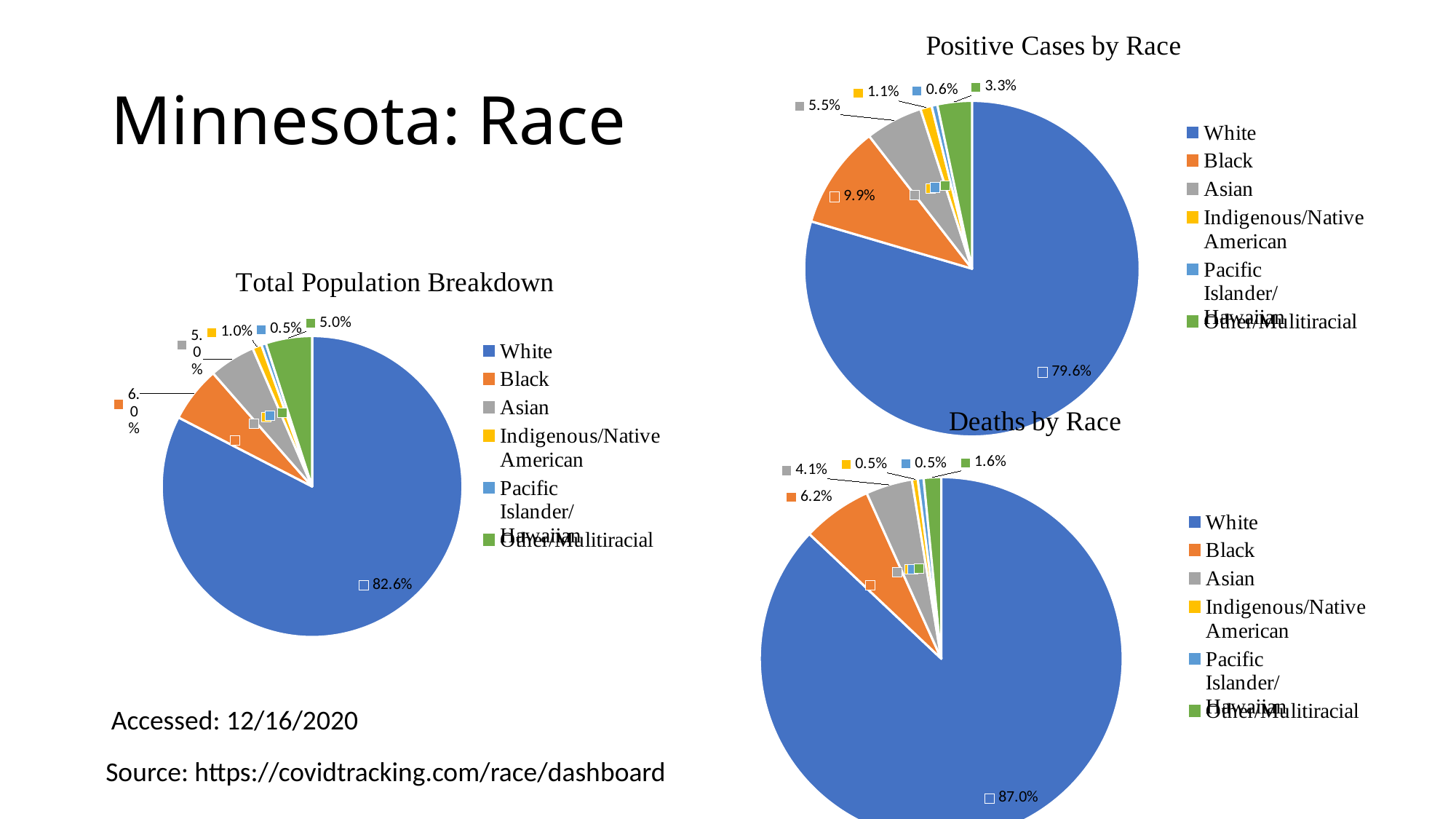
In the Positive Cases by Race chart, what percentage is shown for White? 79.6% Which is larger: the Black share in the Positive Cases by Race chart or the Black share in the Deaths by Race chart? Positive Cases by Race In the Deaths by Race chart, what is the difference between the White share and the Black share? 80.8% In the Total Population Breakdown chart, what percentage is shown for White? 82.6% In the Positive Cases by Race chart, which race has the largest share? White In the Positive Cases by Race chart, what percentage is shown for Asian? 5.5% How many slices does the Deaths by Race pie chart have? 6 In the Deaths by Race chart, what percentage is shown for Other/Multiracial? 1.6% How many charts are shown on the slide? 3 In the Deaths by Race chart, what percentage is shown for Black? 6.2% What type of chart is the Total Population Breakdown chart? Pie chart In the Positive Cases by Race chart, which race has the smallest share? Pacific Islander/Hawaiian